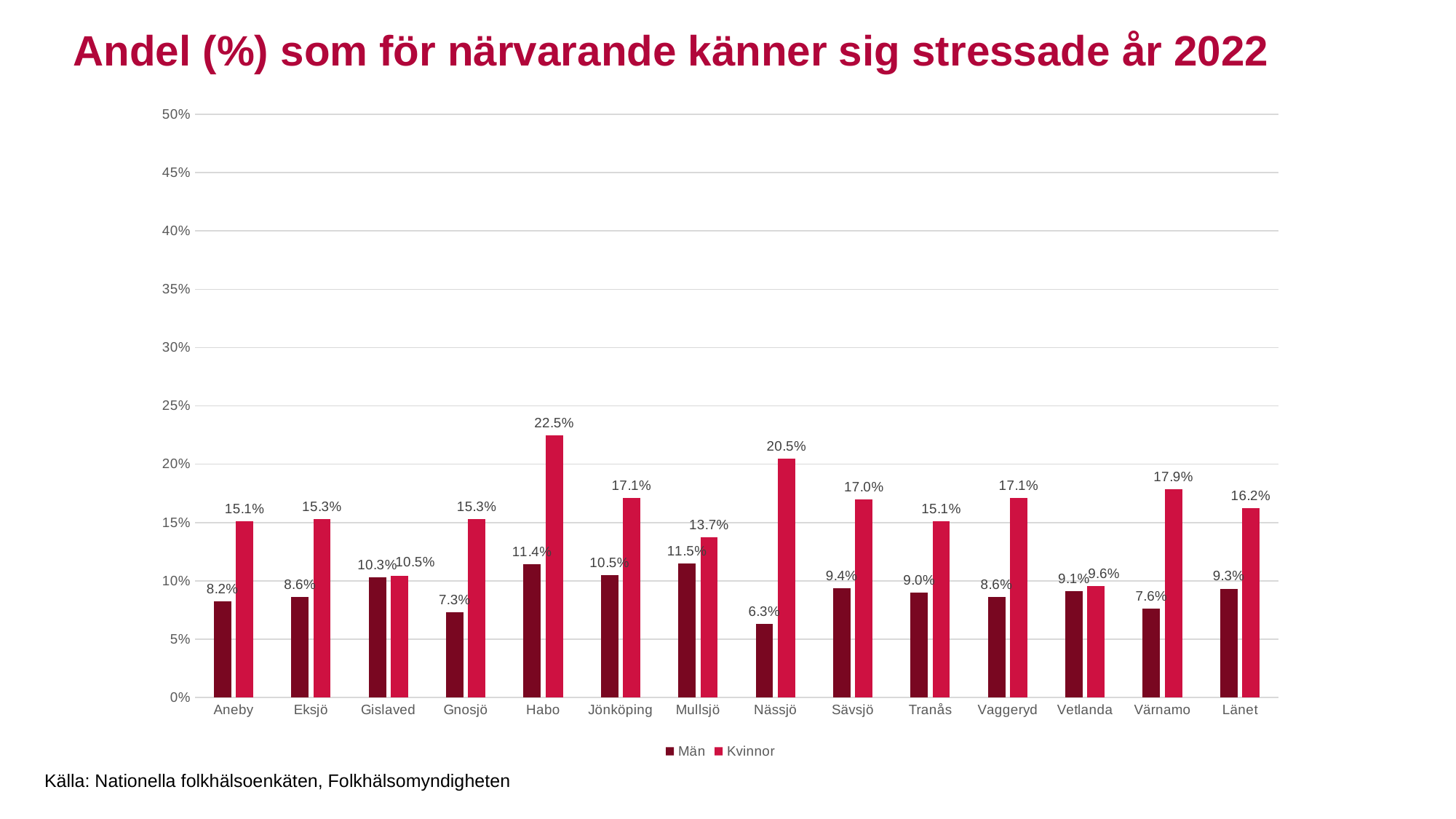
What is the value for Män in Nässjö? 6.3% Which municipality has the highest value for Kvinnor? Habo What is the value for Kvinnor in Länet? 16.2% Which category has the lowest value for Män? Nässjö How many categories are shown on the x axis? 14 What kind of chart is shown on the slide? Bar chart What is the difference between the Kvinnor and Män values in Habo? 11.1 percentage points Which category has the lowest value for Kvinnor? Vetlanda What is the value for Kvinnor in Habo? 22.5% How many series does the legend list? 2 Which is larger in Vetlanda, the value for Män or for Kvinnor? Kvinnor Is the value for Kvinnor in Habo greater or less than 20%? greater